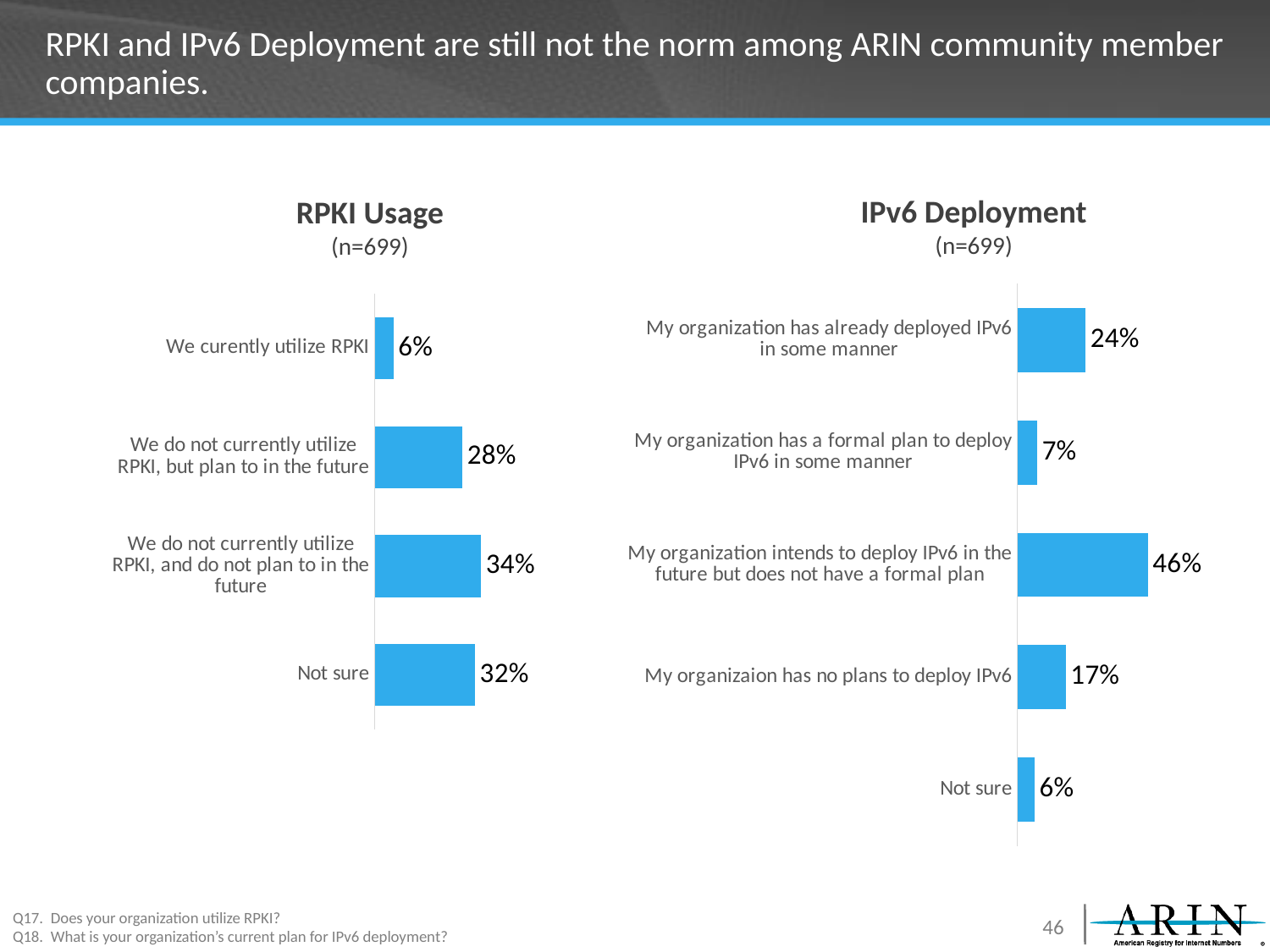
In the IPv6 Deployment chart, which category has the highest value? My organization intends to deploy IPv6 in the future but does not have a formal plan In the RPKI Usage chart, what is the difference between 'Not sure' and 'We do not currently utilize RPKI, but plan to in the future'? 4% What sample size (n) is shown under the IPv6 Deployment chart title? n=699 In the RPKI Usage chart, which category has the highest value? We do not currently utilize RPKI, and do not plan to in the future In the RPKI Usage chart, what percentage of respondents said they currently utilize RPKI? 6% In the IPv6 Deployment chart, which is larger: 'My organizaion has no plans to deploy IPv6' or 'My organization has a formal plan to deploy IPv6 in some manner'? My organizaion has no plans to deploy IPv6 What type of chart is the RPKI Usage chart? Bar chart In the IPv6 Deployment chart, what is the difference between 'My organization has already deployed IPv6 in some manner' and 'My organization has a formal plan to deploy IPv6 in some manner'? 17% In the IPv6 Deployment chart, what percentage said their organization has already deployed IPv6 in some manner? 24% In the RPKI Usage chart, how many categories are shown? 4 In the IPv6 Deployment chart, how many categories are shown? 5 In the IPv6 Deployment chart, which category has the lowest value? Not sure